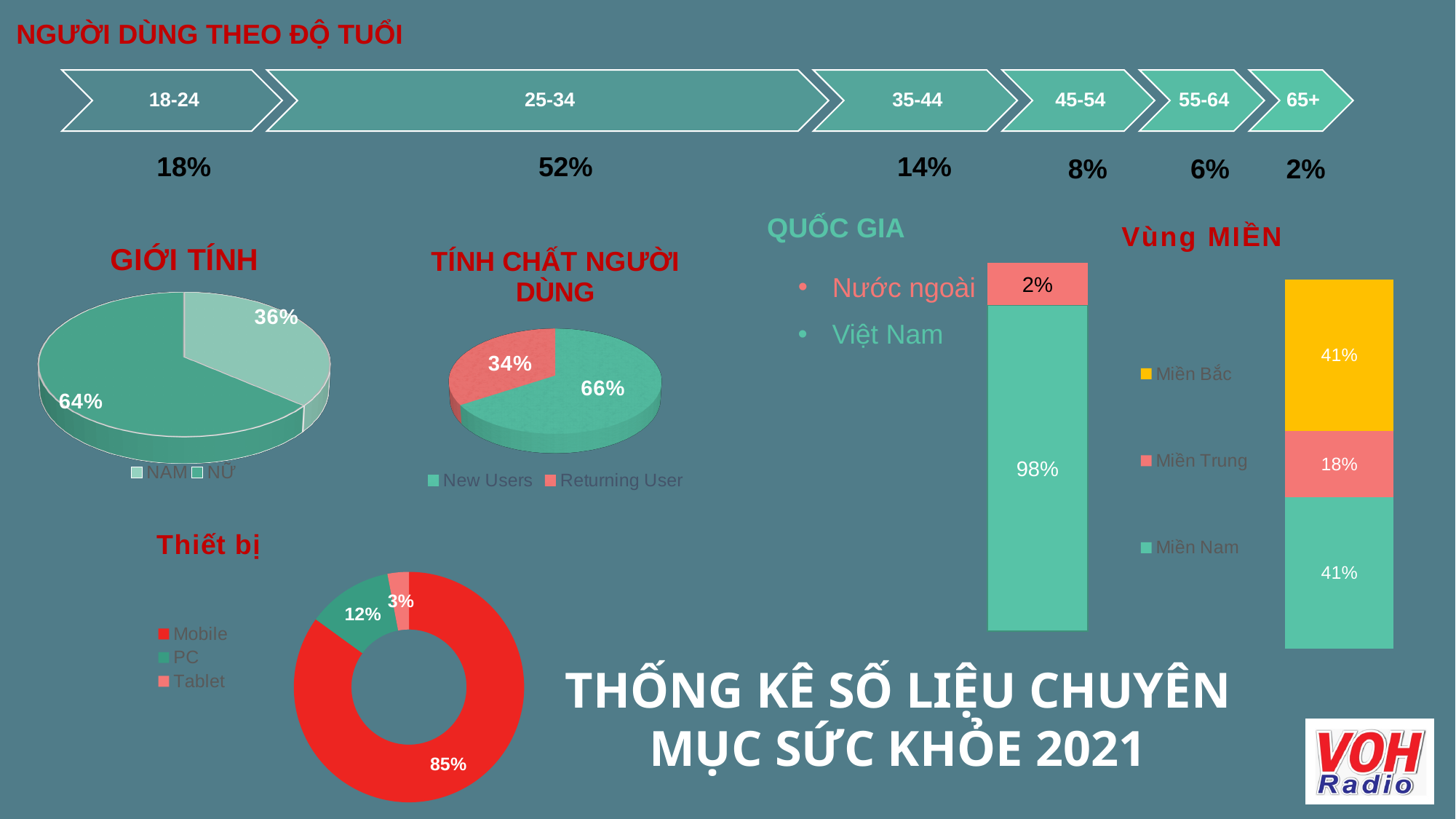
In the GIỚI TÍNH pie chart, what share is labelled for NỮ? 64% In the QUỐC GIA stacked bar chart, what is the value for Nước ngoài? 2% In the Thiết bị chart, what is the value for Mobile? 85% In the TÍNH CHẤT NGƯỜI DÙNG pie chart, what is the value for New Users? 66% In the Vùng MIỀN stacked bar chart, what is the total of the three segments? 100% In the GIỚI TÍNH pie chart, what share is labelled for NAM? 36% In the Vùng MIỀN stacked bar chart, which region has the lowest value? Miền Trung In the QUỐC GIA stacked bar chart, which segment is larger, Việt Nam or Nước ngoài? Việt Nam In the Thiết bị chart, which device has the smallest share? Tablet In the TÍNH CHẤT NGƯỜI DÙNG pie chart, what is the difference between New Users and Returning User? 32% How many entries does the legend of the Thiết bị chart list? 3 In the Vùng MIỀN stacked bar chart, what is the value for Miền Trung? 18%